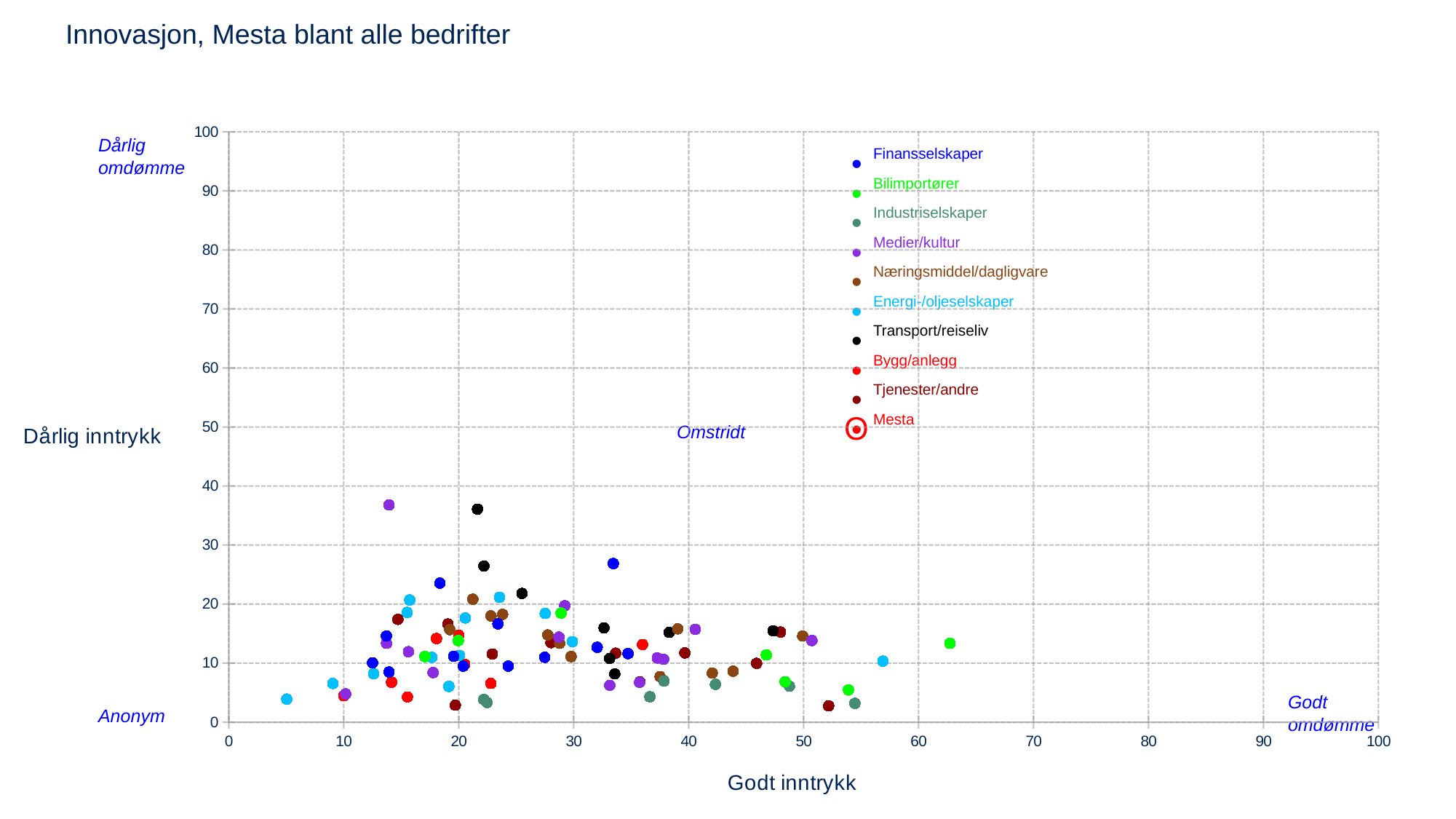
Is the highest vertical-axis value reached by any point greater or less than 40? less Which series has the point with the lowest horizontal-axis value? Energi-/oljeselskaper What is the label of the horizontal axis? Godt inntrykk Is the vertical-axis value of the highest point greater or less than 30? greater How many series does the legend list? 10 Are there any points plotted with a horizontal-axis value greater than 70? No What kind of chart is shown on the slide? scatter chart Which series does the highest point on the chart belong to? Medier/kultur Which series has the point with the highest horizontal-axis value? Bilimportører What is the title of the chart? Innovasjon, Mesta blant alle bedrifter